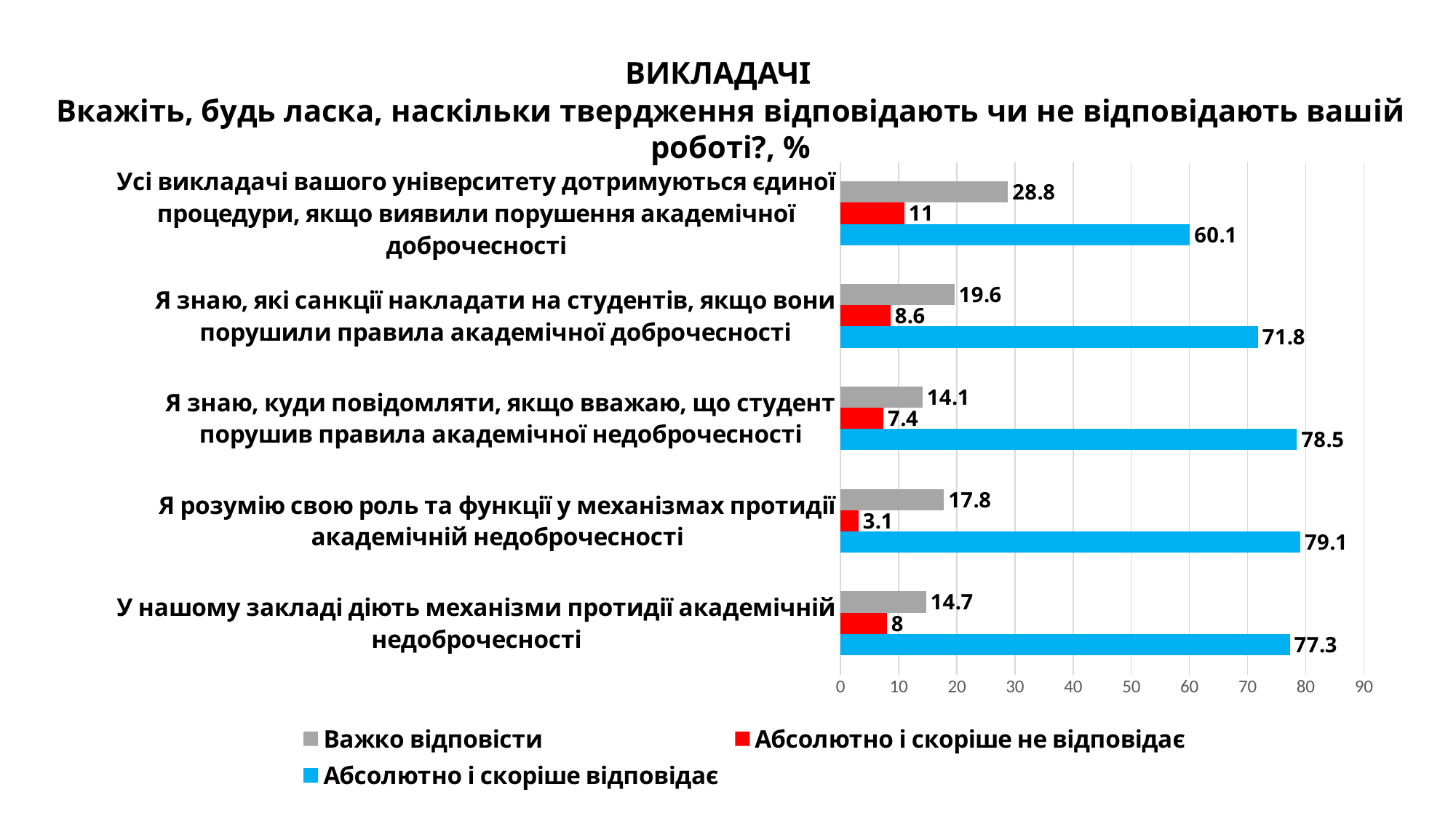
Which colour represents the series "Абсолютно і скоріше не відповідає"? Red Which statement has the lowest value for "Абсолютно і скоріше не відповідає"? Я розумію свою роль та функції у механізмах протидії академічній недоброчесності How many statements (categories) are shown in the chart? 5 What kind of chart is shown on the slide? Bar chart Which statement has the highest value for "Абсолютно і скоріше відповідає"? Я розумію свою роль та функції у механізмах протидії академічній недоброчесності Which is larger: the "Важко відповісти" value for "Я розумію свою роль та функції у механізмах протидії академічній недоброчесності" or for "У нашому закладі діють механізми протидії академічній недоброчесності"? Я розумію свою роль та функції у механізмах протидії академічній недоброчесності What is the value of "Важко відповісти" for the statement "Усі викладачі вашого університету дотримуються єдиної процедури, якщо виявили порушення академічної доброчесності"? 28.8 What is the value of "Абсолютно і скоріше відповідає" for the statement "Я знаю, які санкції накладати на студентів, якщо вони порушили правила академічної доброчесності"? 71.8 What is the value of "Абсолютно і скоріше не відповідає" for the statement "Я розумію свою роль та функції у механізмах протидії академічній недоброчесності"? 3.1 What is the difference between the "Абсолютно і скоріше відповідає" values for "Я знаю, куди повідомляти, якщо вважаю, що студент порушив правила академічної недоброчесності" and "Усі викладачі вашого університету дотримуються єдиної процедури, якщо виявили порушення академічної доброчесності"? 18.4 Which statement has the lowest value for "Абсолютно і скоріше відповідає"? Усі викладачі вашого університету дотримуються єдиної процедури, якщо виявили порушення академічної доброчесності How many series does the legend list? 3